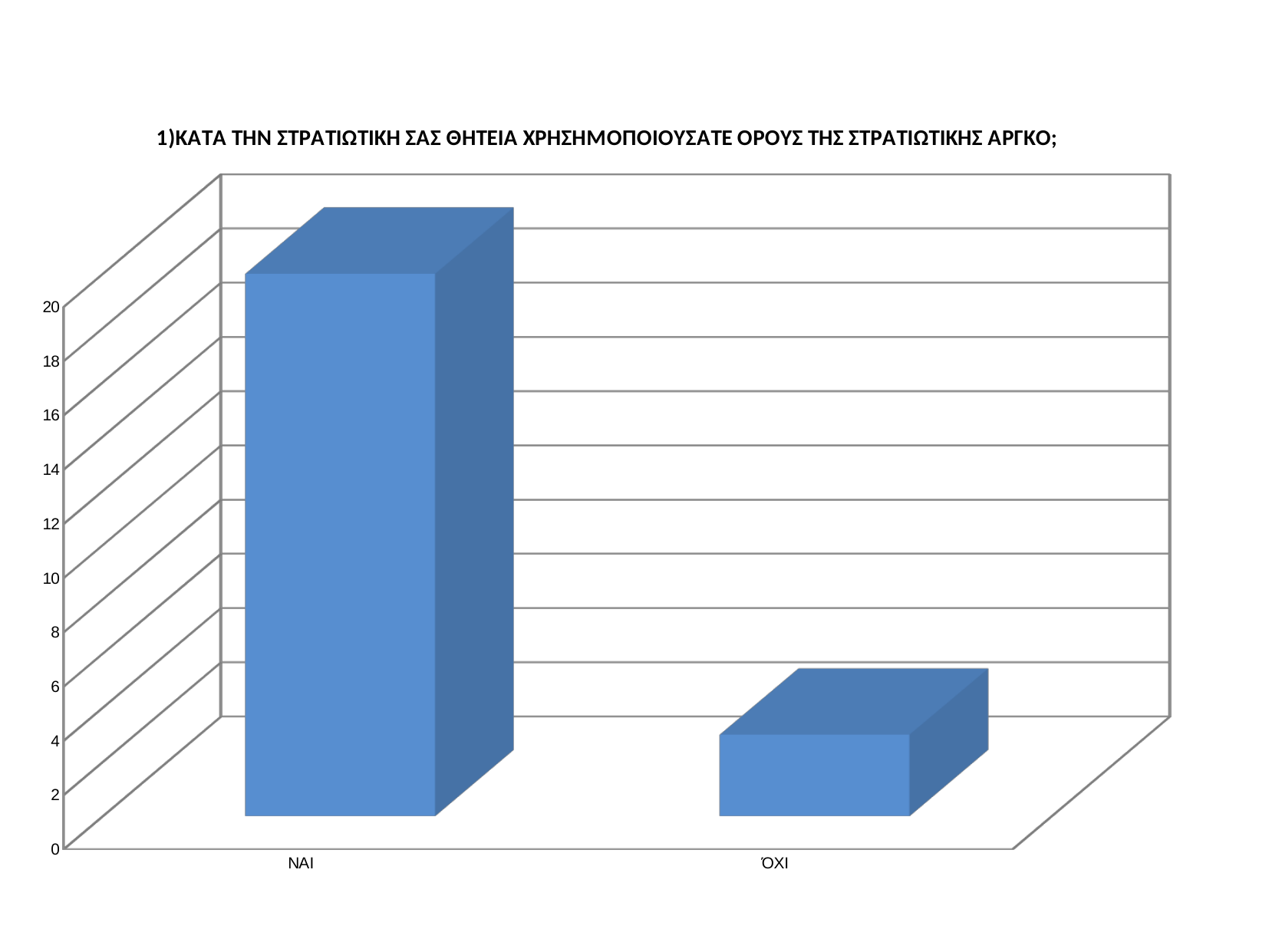
Is the value for ΝΑΙ greater or less than 10? greater How many categories are shown on the x axis of the chart? 2 Which category has the lowest bar in the chart? ΌΧΙ Which category has the highest bar in the chart? ΝΑΙ Is the value for ΌΧΙ greater or less than 6? less What is the highest value shown on the vertical axis of the chart? 20 Is the value for ΌΧΙ greater or less than 10? less Do the bar values rise or fall moving from ΝΑΙ to ΌΧΙ along the x axis? fall Which is larger, the value for ΝΑΙ or the value for ΌΧΙ? ΝΑΙ What kind of chart is shown on the slide? bar chart What is the title of the chart? 1)ΚΑΤΑ ΤΗΝ ΣΤΡΑΤΙΩΤΙΚΗ ΣΑΣ ΘΗΤΕΙΑ ΧΡΗΣΗΜΟΠΟΙΟΥΣΑΤΕ ΟΡΟΥΣ ΤΗΣ ΣΤΡΑΤΙΩΤΙΚΗΣ ΑΡΓΚΟ;